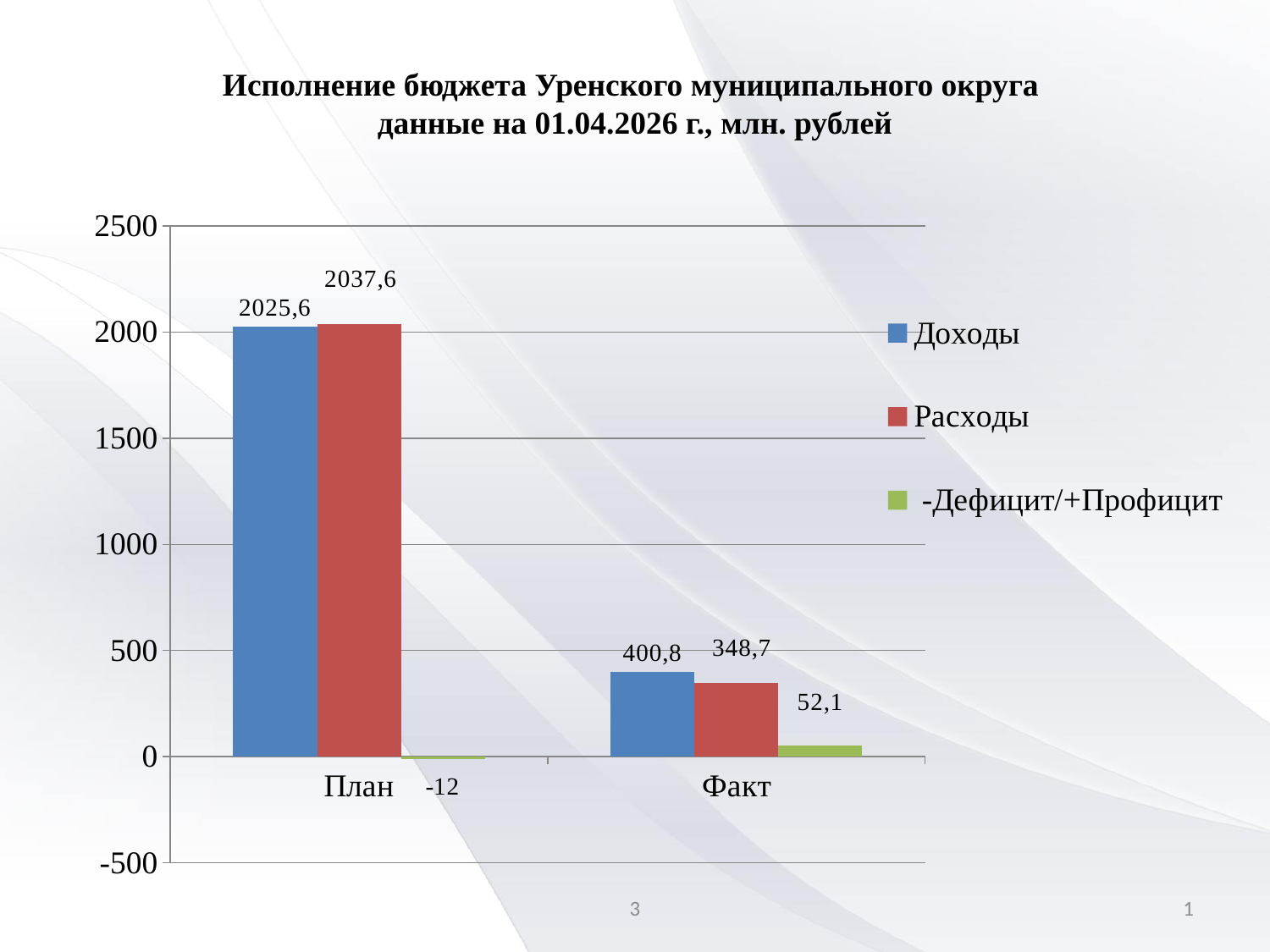
What kind of chart is shown on the slide? bar chart How many series does the legend list? 3 What is the value of Расходы for Факт? 348,7 What is the difference between Расходы and Доходы for План? 12 Which series is shown in green in the legend? -Дефицит/+Профицит What is the value of Доходы for План? 2025,6 What is the value of -Дефицит/+Профицит for Факт? 52,1 Is the value of Доходы for Факт greater or less than 500? less What is the difference between Доходы and Расходы for Факт? 52,1 What is the value of -Дефицит/+Профицит for План? -12 Which category has the higher value for Расходы, План or Факт? План How many categories are shown on the x axis? 2